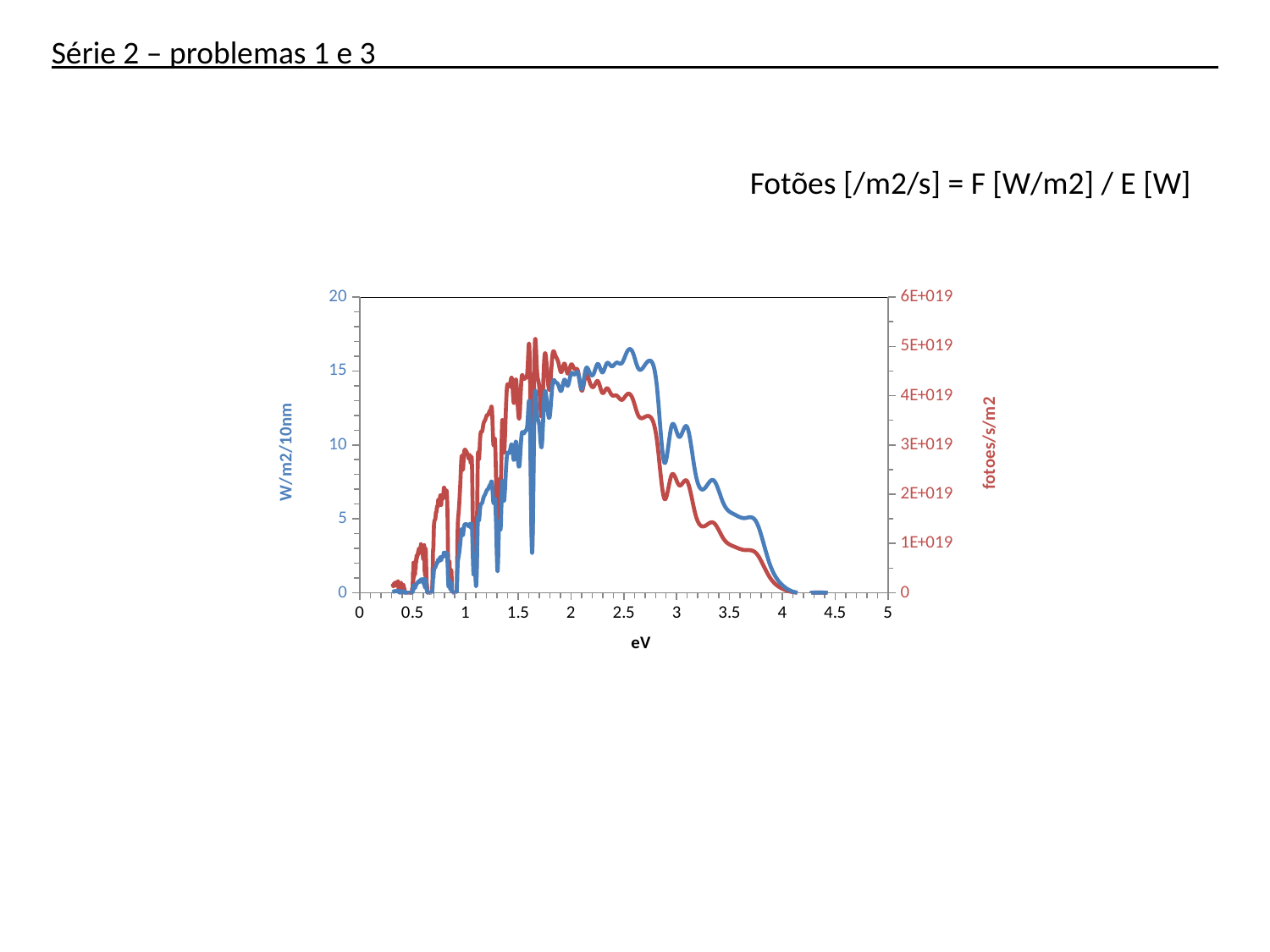
Is the value of the red line at 2 eV greater or less than 4E+019 on the right axis? greater What is the label of the left (blue) vertical axis of the chart? W/m2/10nm How many lines are plotted on the chart? 2 What kind of chart is shown on the slide? line chart Does the blue line rise or fall as eV increases from 3 to 4? fall Is the value of the blue line at 3.5 eV greater or less than 10 on the left axis? less What is the label of the x axis of the chart? eV Is the value of the blue line at 4 eV greater or less than 5 on the left axis? less Does the red line overall rise or fall as eV increases from 0.5 to 1.5? rise